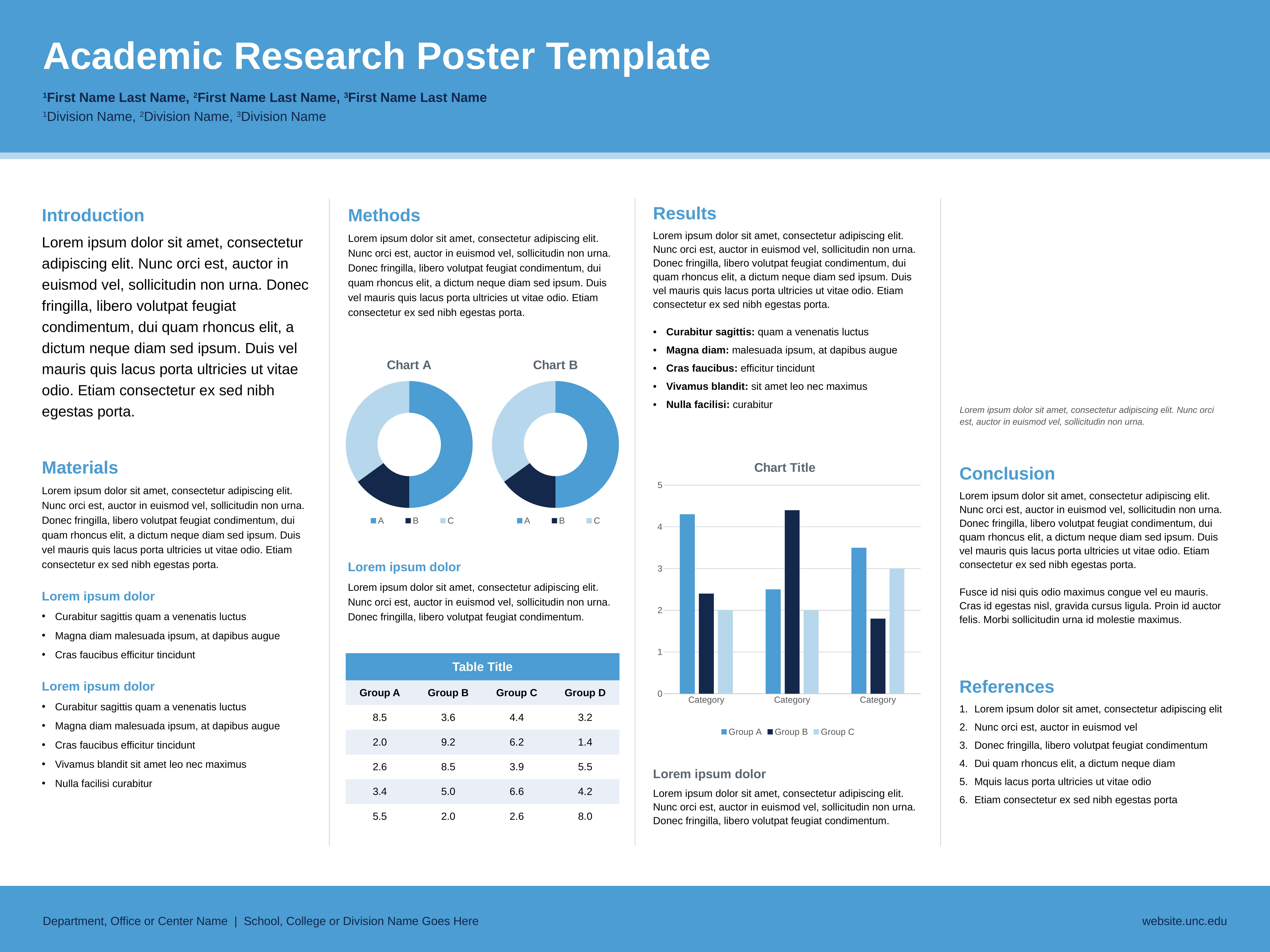
In the chart titled "Chart Title", is the value for Group A in the first category greater or less than 4? greater In Chart B, which slice is the smallest? B What kind of chart is the chart titled "Chart Title"? bar chart In the chart titled "Chart Title", which series has the shortest bar in the third category? Group B In the chart titled "Chart Title", which series has the tallest bar in the first category? Group A In the chart titled "Chart Title", is the value for Group B in the third category greater or less than 2? less In Chart A, which slice is the largest? A In the chart titled "Chart Title", how many categories are shown on the x axis? 3 In the chart titled "Chart Title", which series has the tallest bar in the second category? Group B What kind of chart is Chart A? donut chart In the chart titled "Chart Title", how many series does the legend list? 3 In the chart titled "Chart Title", is Group A or Group B larger in the second category? Group B